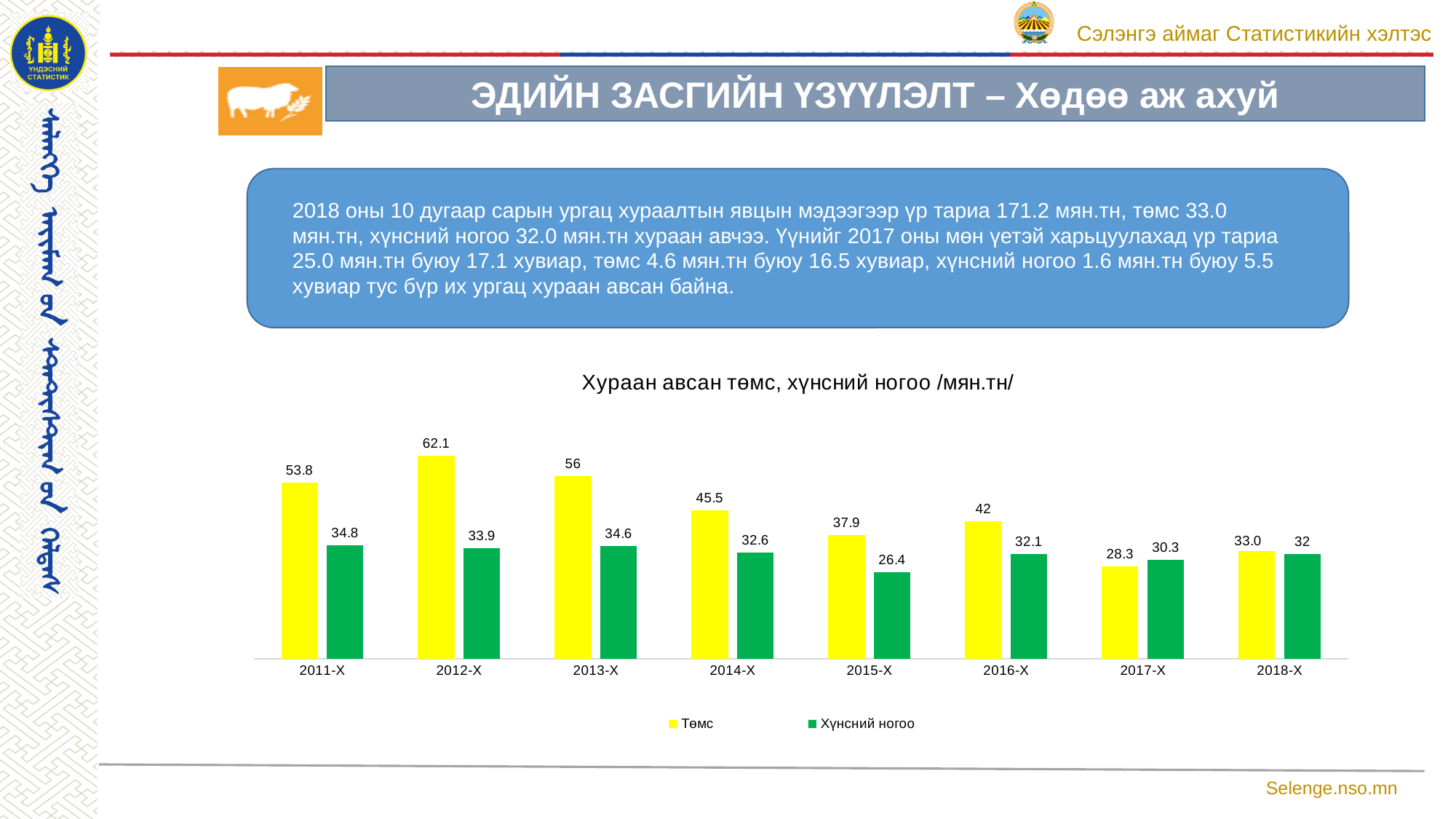
How many years are shown on the x axis? 8 What is the value for Хүнсний ногоо in 2015-X? 26.4 In which year is the Хүнсний ногоо value lowest? 2015-X What is the value for Төмс in 2012-X? 62.1 In which year is the Төмс value lowest? 2017-X What is the value for Төмс in 2018-X? 33.0 What kind of chart is shown? Bar chart What is the title of the chart? Хураан авсан төмс, хүнсний ногоо /мян.тн/ In which year is the Төмс value highest? 2012-X How many series does the legend list? 2 Which is larger in 2017-X, Төмс or Хүнсний ногоо? Хүнсний ногоо What is the difference between the Төмс and Хүнсний ногоо values in 2011-X? 19.0